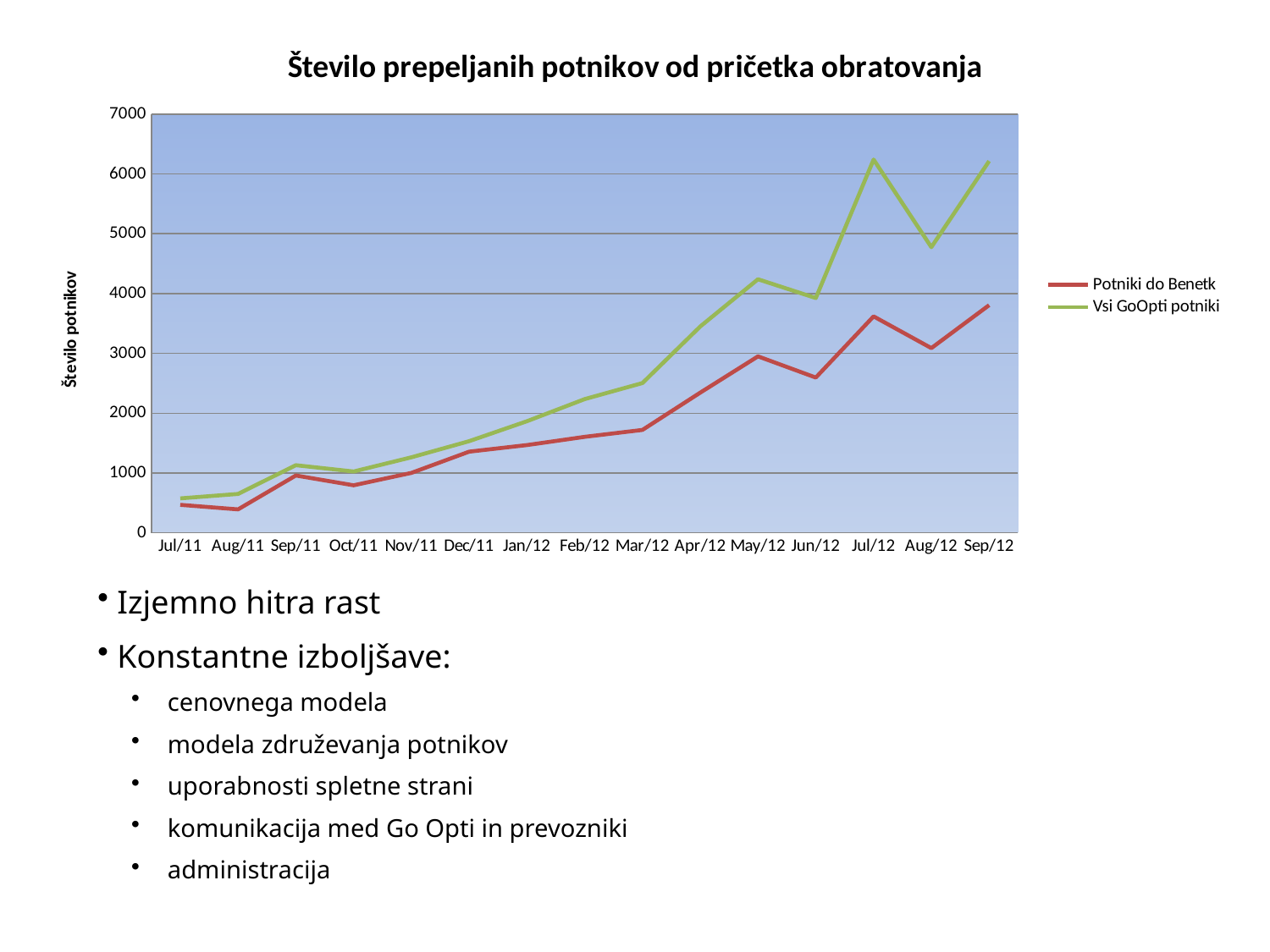
How many months are plotted along the x axis? 15 Do the values for Vsi GoOpti potniki generally rise or fall from Jul/11 to Sep/12? rise Is the value for Vsi GoOpti potniki in Jul/12 greater or less than 6000? greater Is the value for Potniki do Benetk in Jul/12 greater or less than 3000? greater For Potniki do Benetk, which month has the higher value, Jul/12 or Aug/12? Jul/12 What is the title of the chart? Število prepeljanih potnikov od pričetka obratovanja How many series does the legend list? 2 In Jul/12, which series has the higher value, Potniki do Benetk or Vsi GoOpti potniki? Vsi GoOpti potniki Is the value for Potniki do Benetk in Dec/11 greater or less than 1000? greater What kind of chart is shown on the slide? line chart